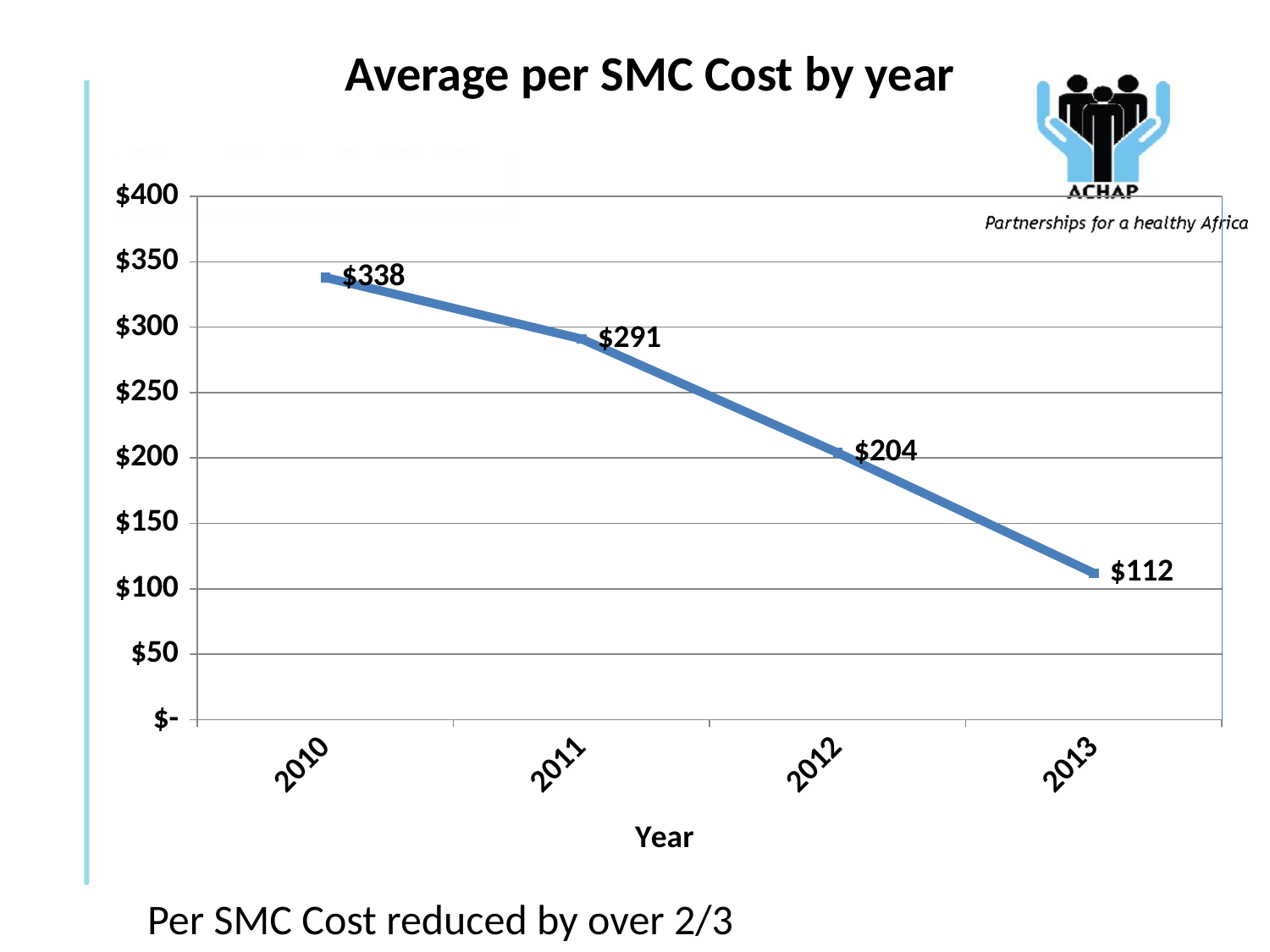
What kind of chart is shown on the slide? Line chart Does the average per SMC cost rise or fall from 2010 to 2013? Fall What is the average per SMC cost in 2011? $291 Which year has the highest average per SMC cost? 2010 How many years are plotted on the chart? 4 What is the average per SMC cost in 2010? $338 Which year has the lowest average per SMC cost? 2013 What is the average per SMC cost in 2012? $204 What is the difference between the average per SMC cost in 2011 and in 2012? $87 What is the average per SMC cost in 2013? $112 What is the difference between the average per SMC cost in 2010 and in 2013? $226 Which year has a higher average per SMC cost, 2011 or 2012? 2011